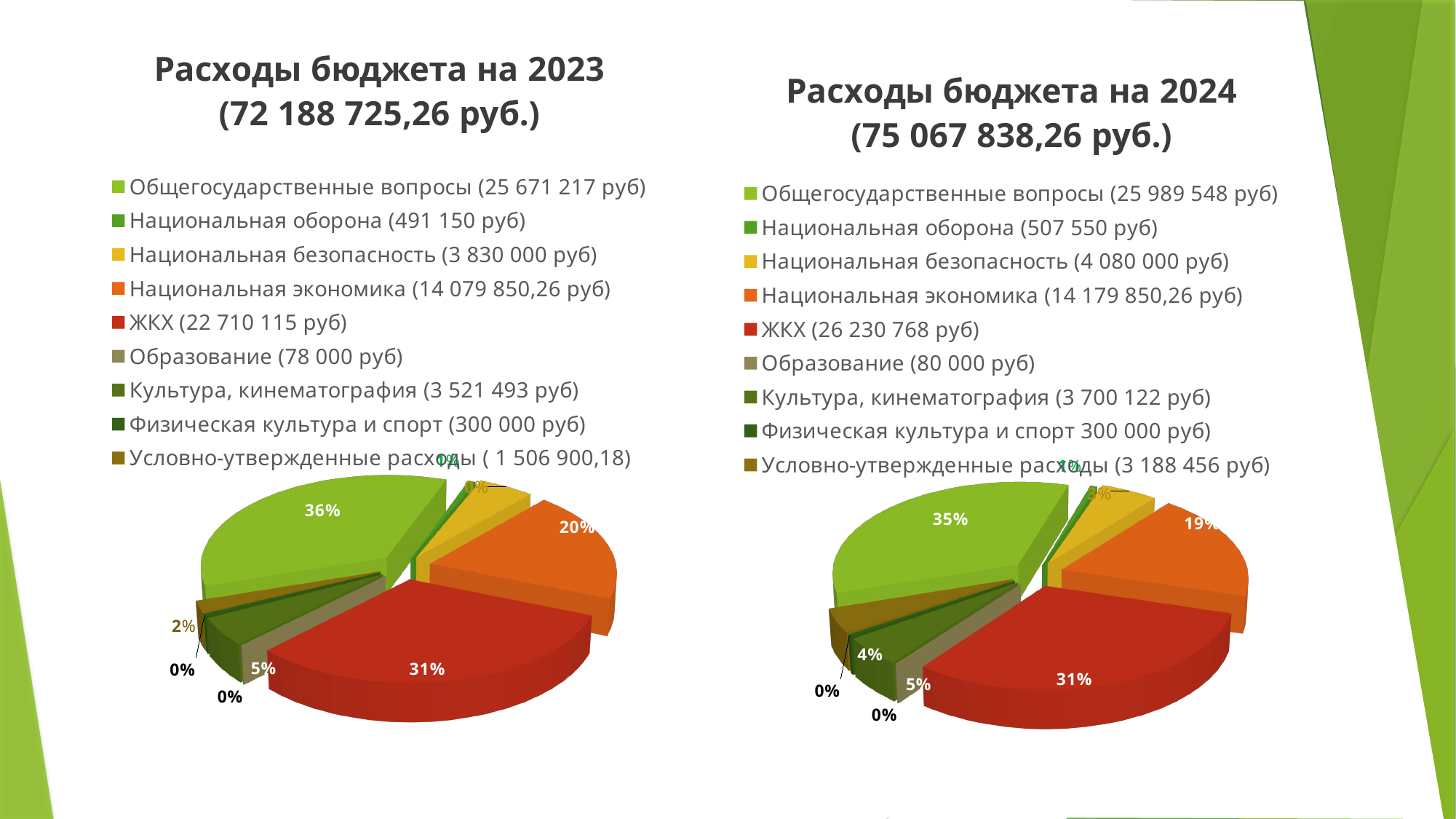
In the 'Расходы бюджета на 2023' chart, what is the value given in the legend for 'ЖКХ'? 22 710 115 руб In the 'Расходы бюджета на 2024' chart, what share of the pie does 'Национальная экономика' take? 19% In the 'Расходы бюджета на 2023' chart, which is larger: the slice for 'Национальная экономика' or the slice for 'ЖКХ'? ЖКХ How many categories does the legend of the 'Расходы бюджета на 2024' chart list? 9 What total budget amount is shown in the title of the right-hand chart? 75 067 838,26 руб. What kind of chart is shown under the title 'Расходы бюджета на 2023'? pie chart In the 'Расходы бюджета на 2023' chart, which category has the largest slice? Общегосударственные вопросы In the 'Расходы бюджета на 2024' chart, what share of the pie does 'ЖКХ' take? 31% In the 'Расходы бюджета на 2024' chart, which category has the smallest value in the legend? Образование What is the difference between the legend values for 'Национальная оборона' in the 2024 chart and in the 2023 chart? 16 400 руб In the 'Расходы бюджета на 2024' chart, what is the value given in the legend for 'Национальная безопасность'? 4 080 000 руб In the 'Расходы бюджета на 2023' chart, what share of the pie does 'Общегосударственные вопросы' take? 36%